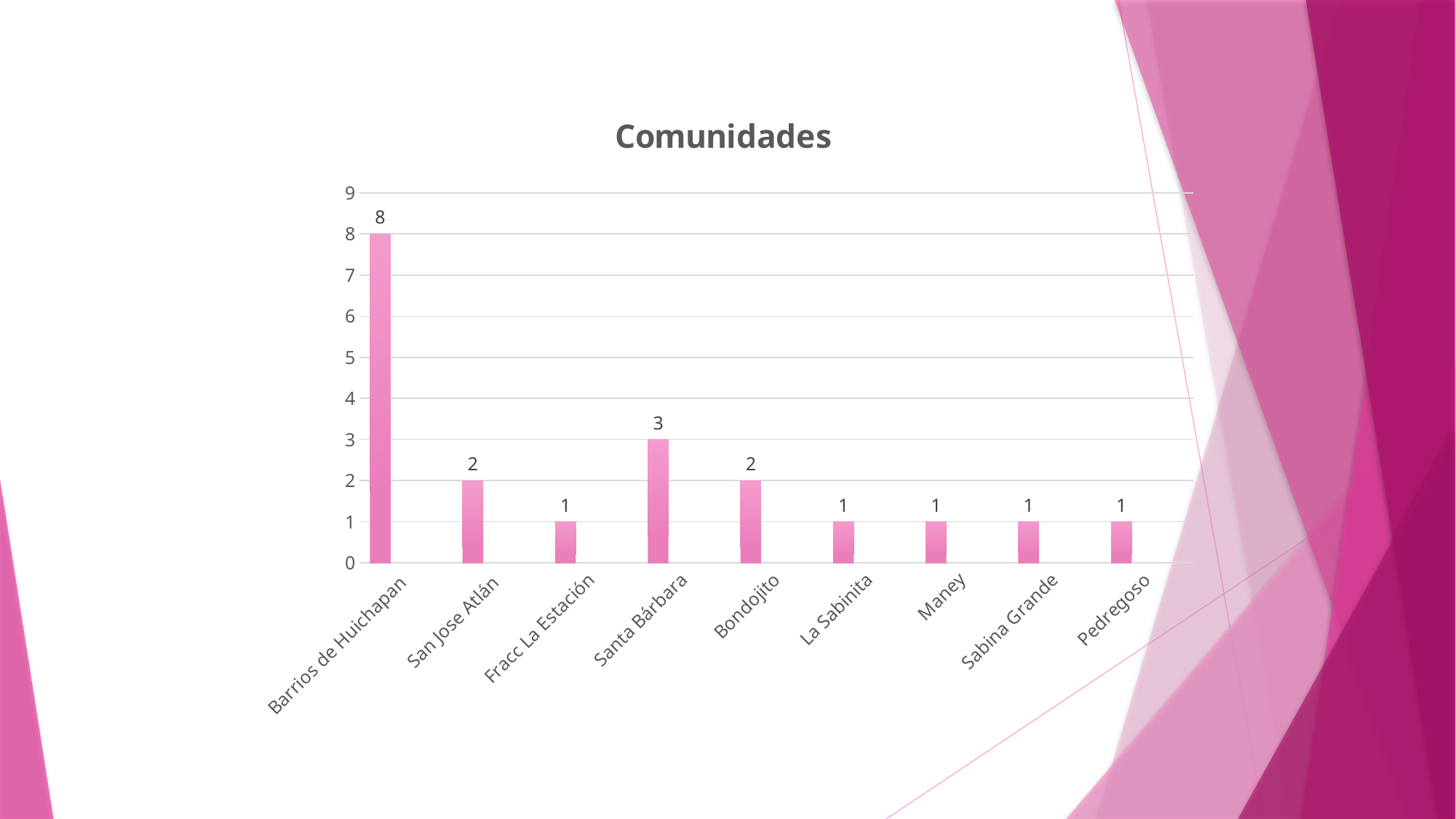
What is the difference between the values for Barrios de Huichapan and Santa Bárbara? 5 What is the difference between the values for San Jose Atlán and Fracc La Estación? 1 What is the value for Santa Bárbara? 3 What kind of chart is shown on the slide? bar chart What is the value for Pedregoso? 1 What is the value for Bondojito? 2 What is the title of the chart? Comunidades Which community has the highest value? Barrios de Huichapan Which is larger, the value for Santa Bárbara or the value for Bondojito? Santa Bárbara How many communities are shown on the chart? 9 What is the value for Barrios de Huichapan? 8 Is the value for Barrios de Huichapan greater or less than 5? greater